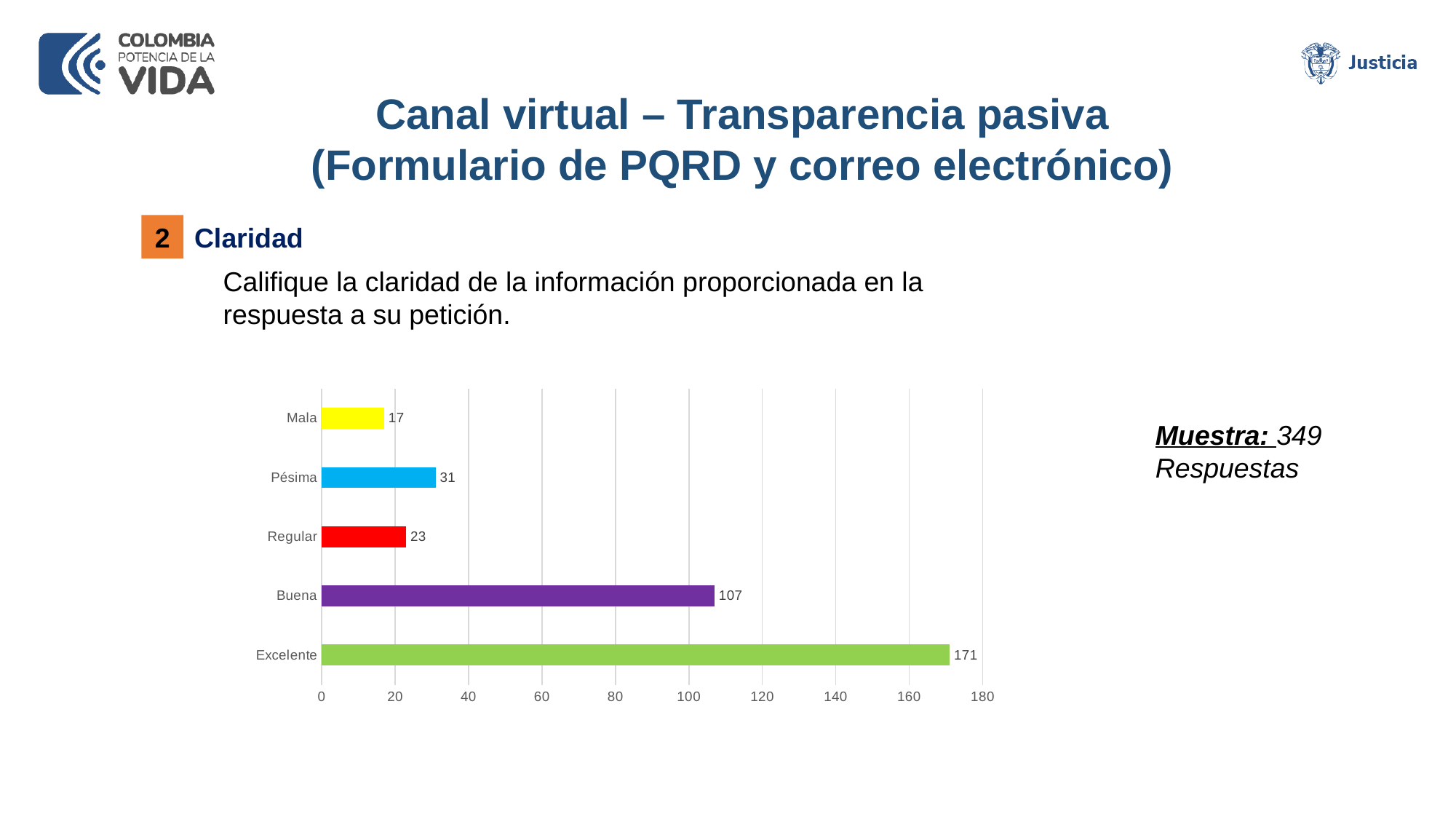
Which is larger, the value for Pésima or the value for Regular? Pésima What is the value for Regular? 23 What is the value for Mala? 17 Which category has the highest value? Excelente How many categories are shown in the chart? 5 What is the value for Pésima? 31 Which category has the lowest value? Mala What is the value for Excelente? 171 What kind of chart is shown on the slide? bar chart What is the value for Buena? 107 What is the difference between the values for Excelente and Buena? 64 Is the value for Buena greater or less than 100? greater